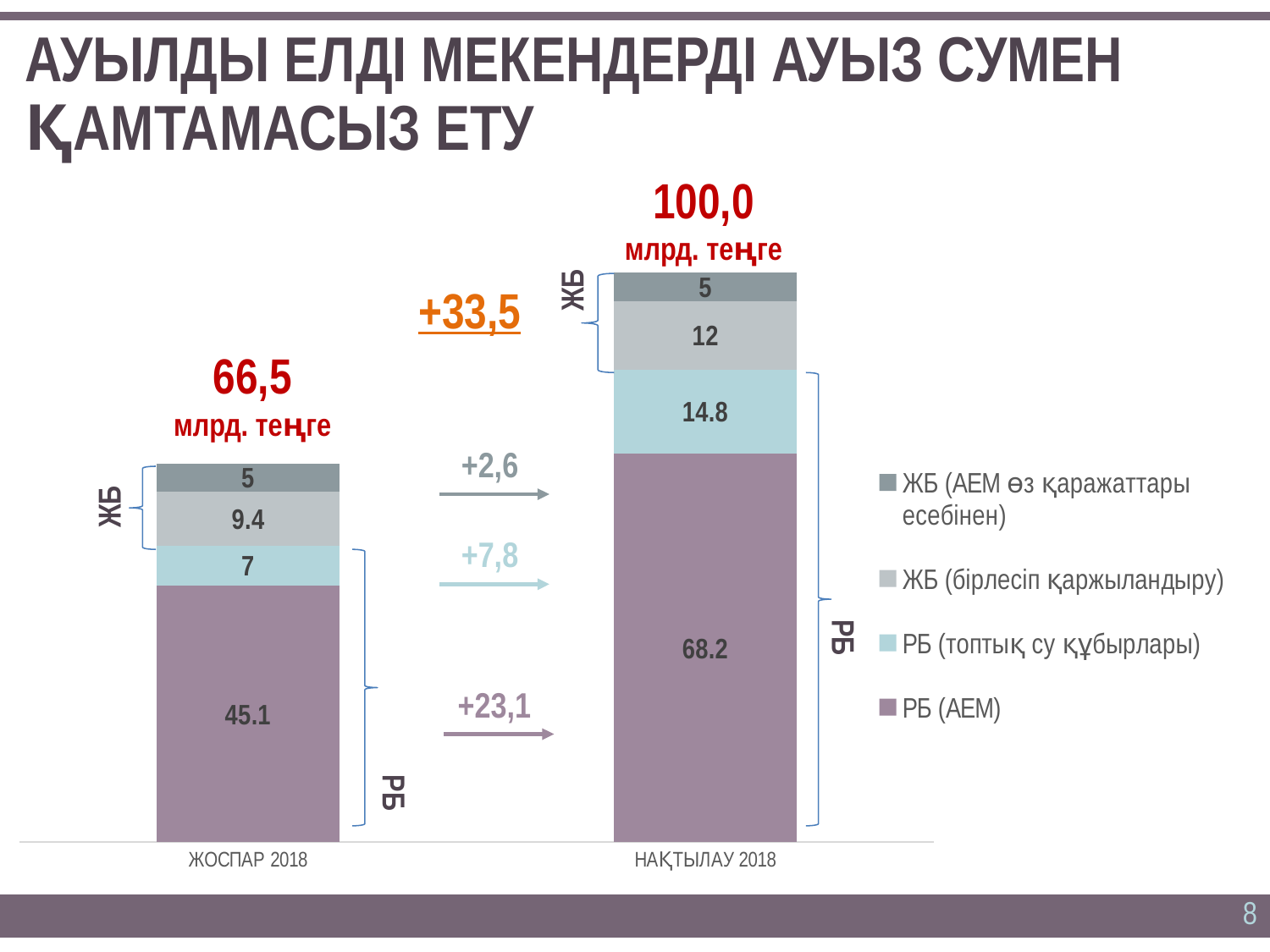
Which category has the larger value for РБ (топтық су құбырлары), ЖОСПАР 2018 or НАҚТЫЛАУ 2018? НАҚТЫЛАУ 2018 What is the difference in РБ (АЕМ) between НАҚТЫЛАУ 2018 and ЖОСПАР 2018? 23.1 How many categories are shown on the x axis? 2 What is the value of РБ (топтық су құбырлары) for НАҚТЫЛАУ 2018? 14.8 What is the value of ЖБ (бірлесіп қаржыландыру) for ЖОСПАР 2018? 9.4 What is the total of the stacked bar for ЖОСПАР 2018? 66,5 What is the value of РБ (АЕМ) for ЖОСПАР 2018? 45.1 How many series does the legend list? 4 What is the value of РБ (АЕМ) for НАҚТЫЛАУ 2018? 68.2 Which series has the largest value in the НАҚТЫЛАУ 2018 bar? РБ (АЕМ) What kind of chart is shown on the slide? Stacked bar chart What is the total of the stacked bar for НАҚТЫЛАУ 2018? 100,0